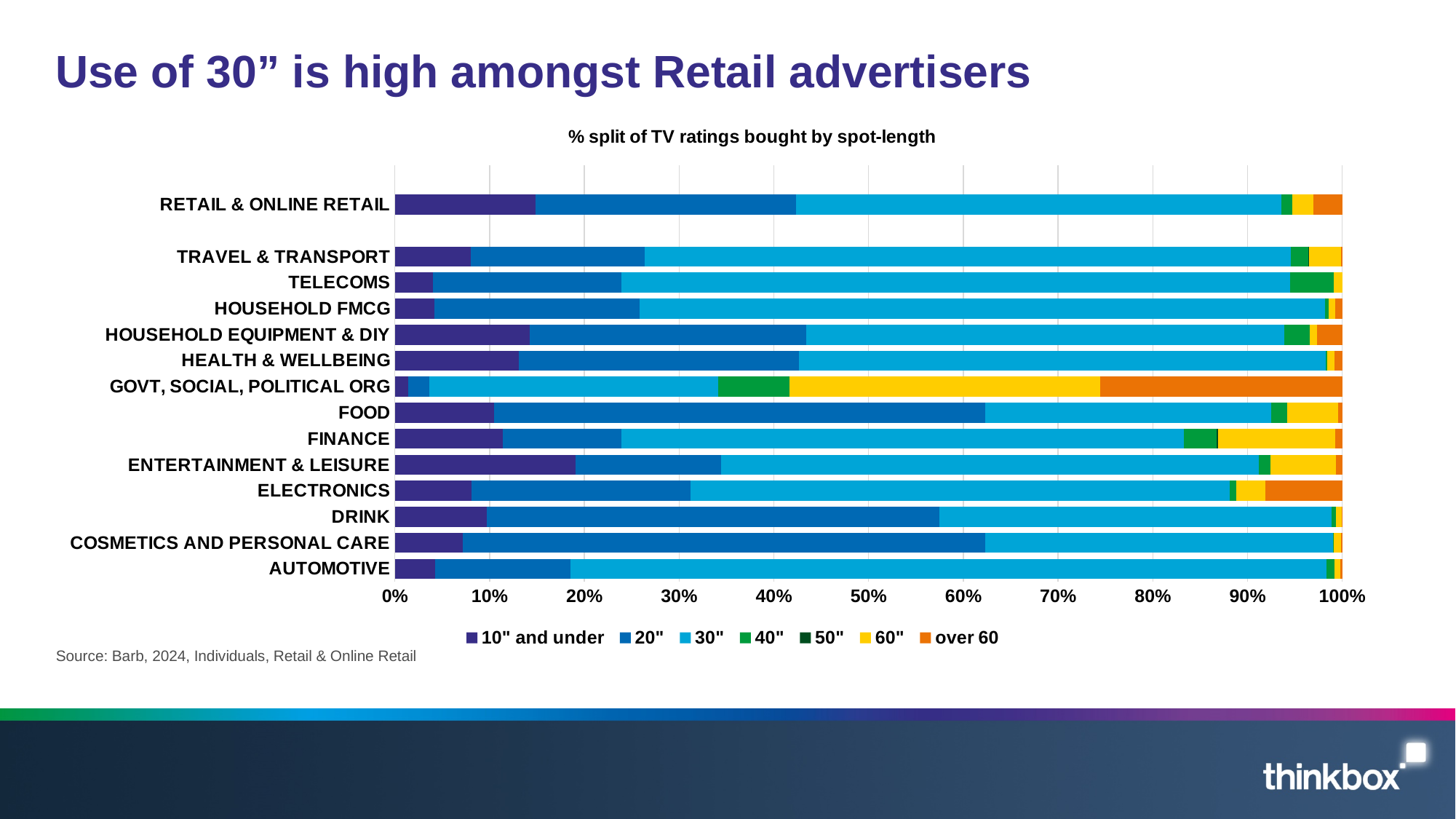
Which category has the largest "30"" segment? AUTOMOTIVE Which category has the largest "10" and under" segment? ENTERTAINMENT & LEISURE Which category has the largest "over 60" segment? GOVT, SOCIAL, POLITICAL ORG Which series is listed first in the legend? 10" and under Is the "over 60" segment for GOVT, SOCIAL, POLITICAL ORG greater or less than 20%? greater Which category has the smallest "10" and under" segment? GOVT, SOCIAL, POLITICAL ORG What is the title of the chart? % split of TV ratings bought by spot-length Is the "10" and under" segment for RETAIL & ONLINE RETAIL greater or less than 10%? greater What kind of chart is shown on the slide? Stacked bar chart How many advertiser categories are plotted on the chart? 14 Which has the larger "20"" segment, FOOD or AUTOMOTIVE? FOOD How many series does the legend list? 7